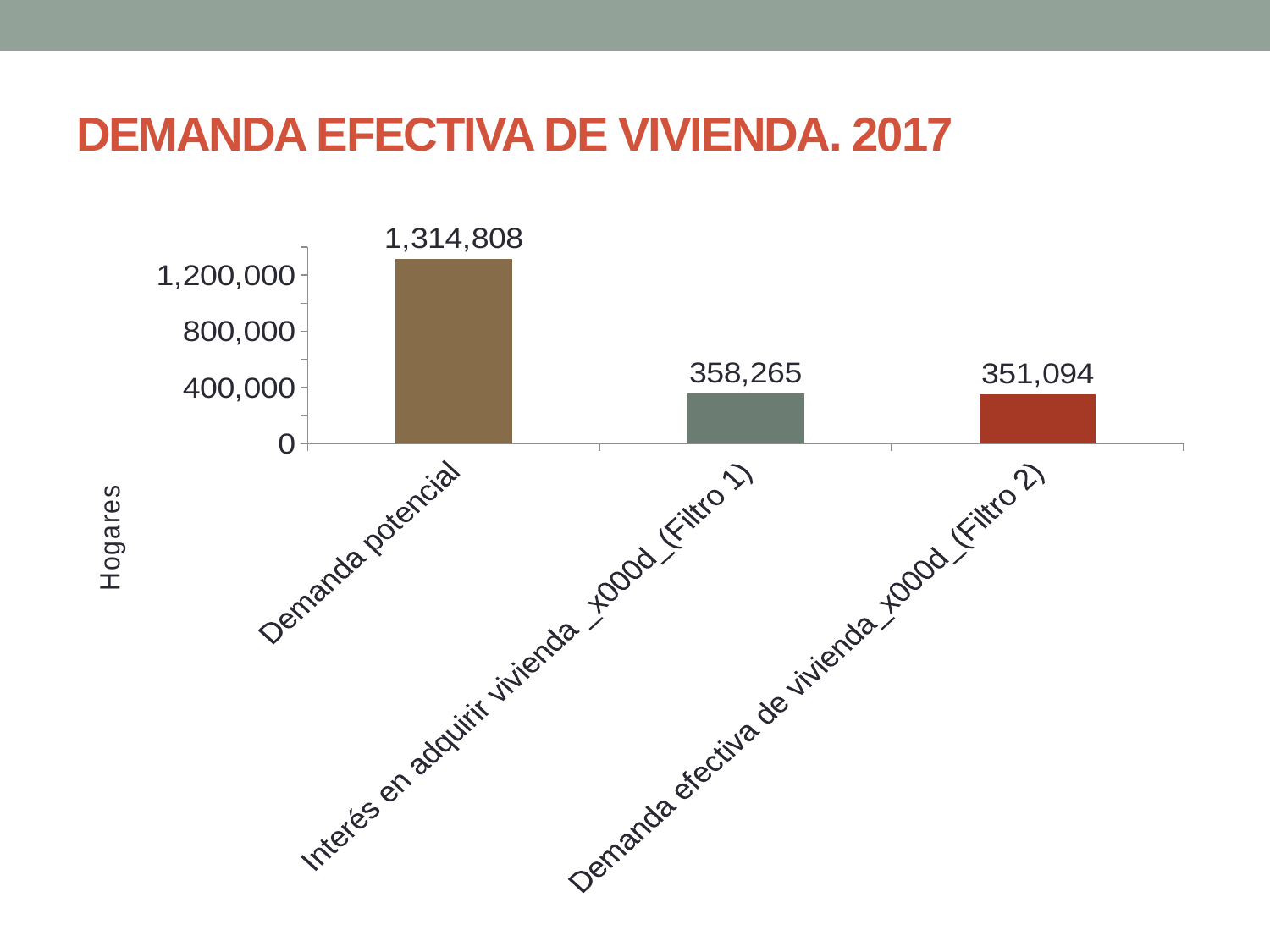
What is the value for Demanda potencial? 1,314,808 What is the label of the vertical axis? Hogares What is the difference between Interés en adquirir vivienda (Filtro 1) and Demanda efectiva de vivienda (Filtro 2)? 7,171 Is the value for Demanda potencial greater or less than 1,200,000? greater How many categories are shown in the chart? 3 Which category has the lowest value? Demanda efectiva de vivienda (Filtro 2) What is the difference between Demanda potencial and Interés en adquirir vivienda (Filtro 1)? 956,543 What kind of chart is shown on the slide? bar chart Which is larger, Interés en adquirir vivienda (Filtro 1) or Demanda efectiva de vivienda (Filtro 2)? Interés en adquirir vivienda (Filtro 1) What is the value for Demanda efectiva de vivienda (Filtro 2)? 351,094 What is the value for Interés en adquirir vivienda (Filtro 1)? 358,265 Which category has the highest value? Demanda potencial